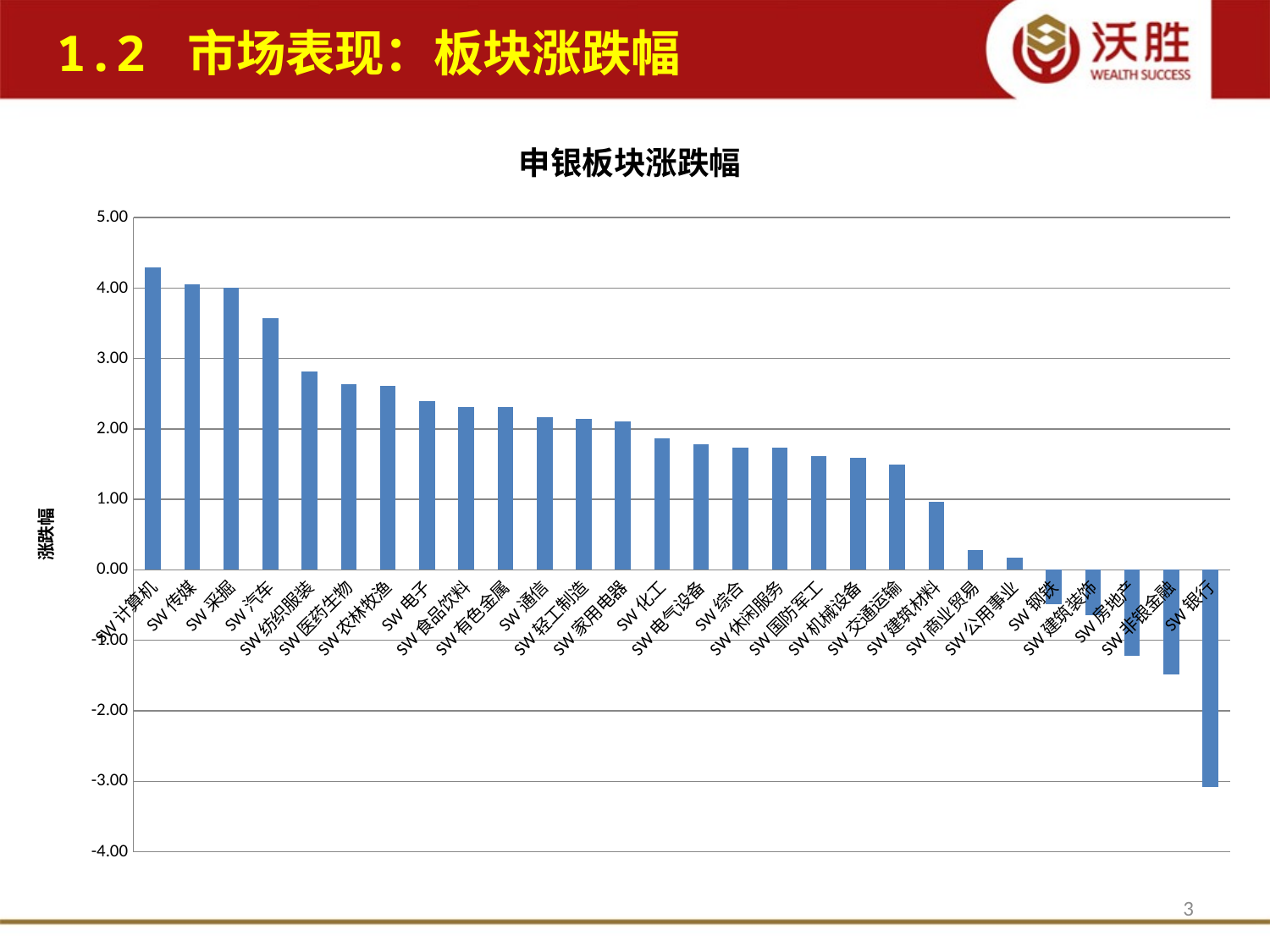
Which sector has the highest value in the chart? SW 计算机 Which sector has the lowest value in the chart? SW 银行 Which is larger, the value for SW 电子 or the value for SW 化工? SW 电子 Do the values generally rise or fall moving from left to right along the x axis? fall Is the value for SW 汽车 greater or less than 3.00? greater Is the value for SW 计算机 greater or less than 4.00? greater Is the value for SW 非银金融 greater or less than -1.00? less What kind of chart is shown on the slide? bar chart What is the label on the vertical axis of the chart? 涨跌幅 What is the title of the chart? 申银板块涨跌幅 How many sectors (bars) are plotted in the chart? 28